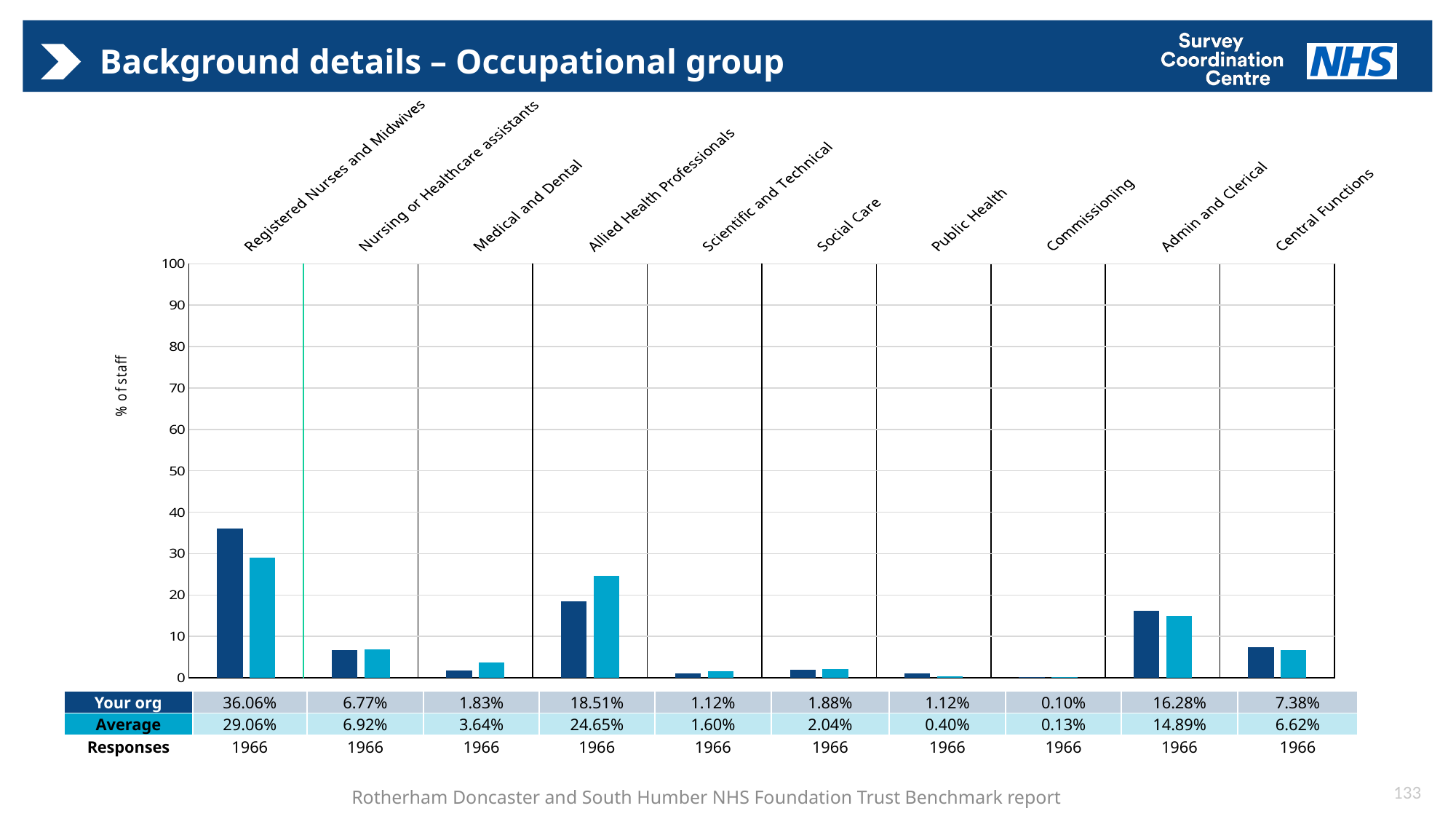
What kind of chart is shown on the slide? bar chart What is the Average value for Allied Health Professionals? 24.65% For Medical and Dental, which is larger: the 'Your org' value or the Average value? Average What is the difference between the Average and 'Your org' values for Allied Health Professionals? 6.14% Which occupational group has the lowest 'Your org' value? Commissioning What is the 'Your org' value for Admin and Clerical? 16.28% Is the 'Your org' value for Registered Nurses and Midwives greater or less than 30? greater How many occupational groups are shown on the chart? 10 What is the 'Your org' value for Registered Nurses and Midwives? 36.06% What is the difference between the 'Your org' and Average values for Registered Nurses and Midwives? 7.00% How many series does the chart show? 2 Which occupational group has the highest 'Your org' value? Registered Nurses and Midwives